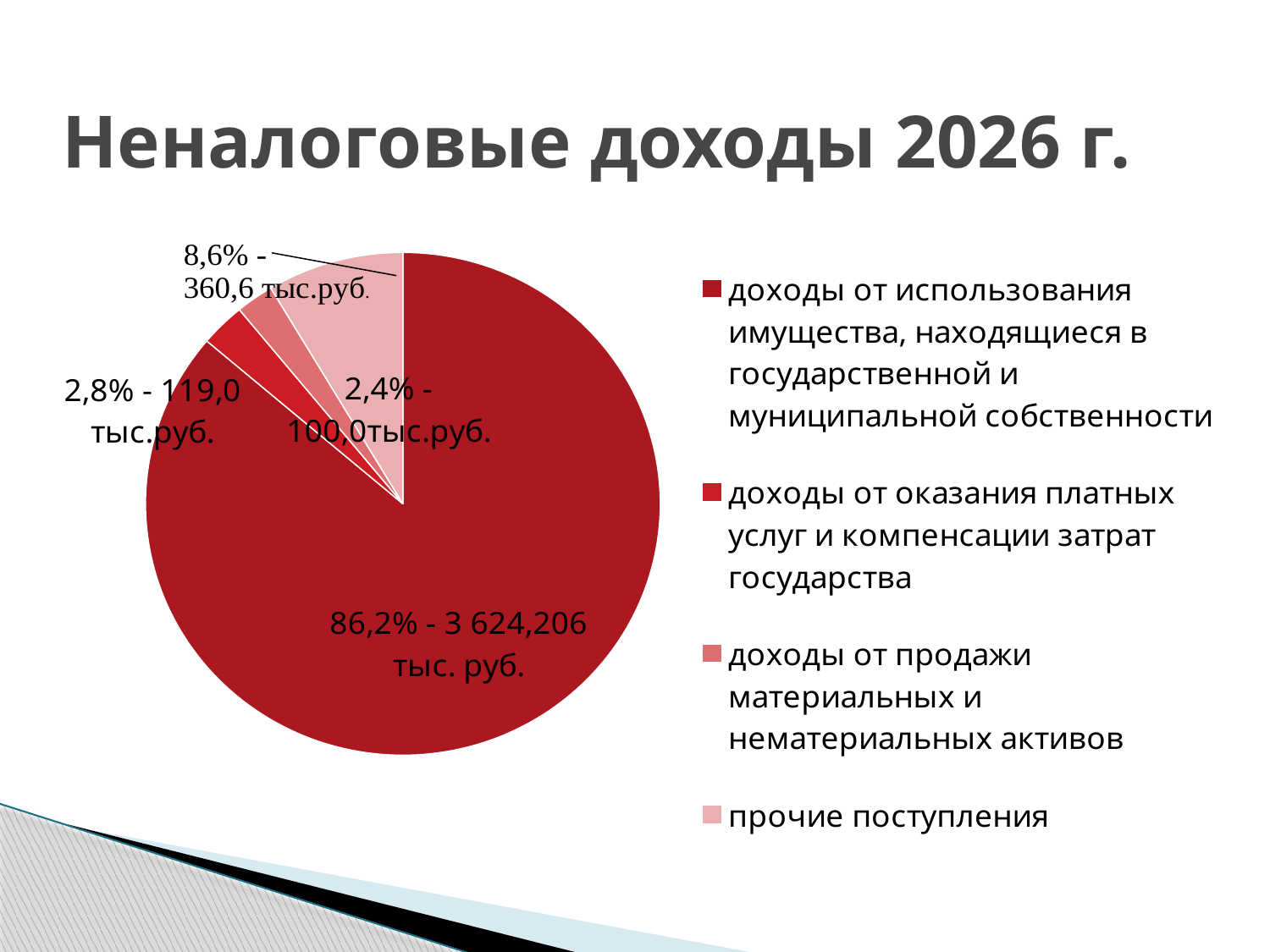
Which is larger: the share for 'прочие поступления' or the share for 'доходы от оказания платных услуг и компенсации затрат государства'? прочие поступления What kind of chart is shown on the slide? pie chart What is the title of the chart on the slide? Неналоговые доходы 2026 г. Which category has the smallest slice of the pie? доходы от продажи материальных и нематериальных активов How many slices does the pie chart have? 4 What value is shown for 'прочие поступления'? 360,6 тыс.руб. What share of the pie is 'доходы от использования имущества, находящиеся в государственной и муниципальной собственности'? 86,2% What value is shown for 'доходы от оказания платных услуг и компенсации затрат государства'? 119,0 тыс.руб. What is the difference in percentage points between the share for 'прочие поступления' and the share for 'доходы от продажи материальных и нематериальных активов'? 6,2% How many entries does the legend list? 4 What share of the pie is 'доходы от продажи материальных и нематериальных активов'? 2,4% Which category has the largest slice of the pie? доходы от использования имущества, находящиеся в государственной и муниципальной собственности